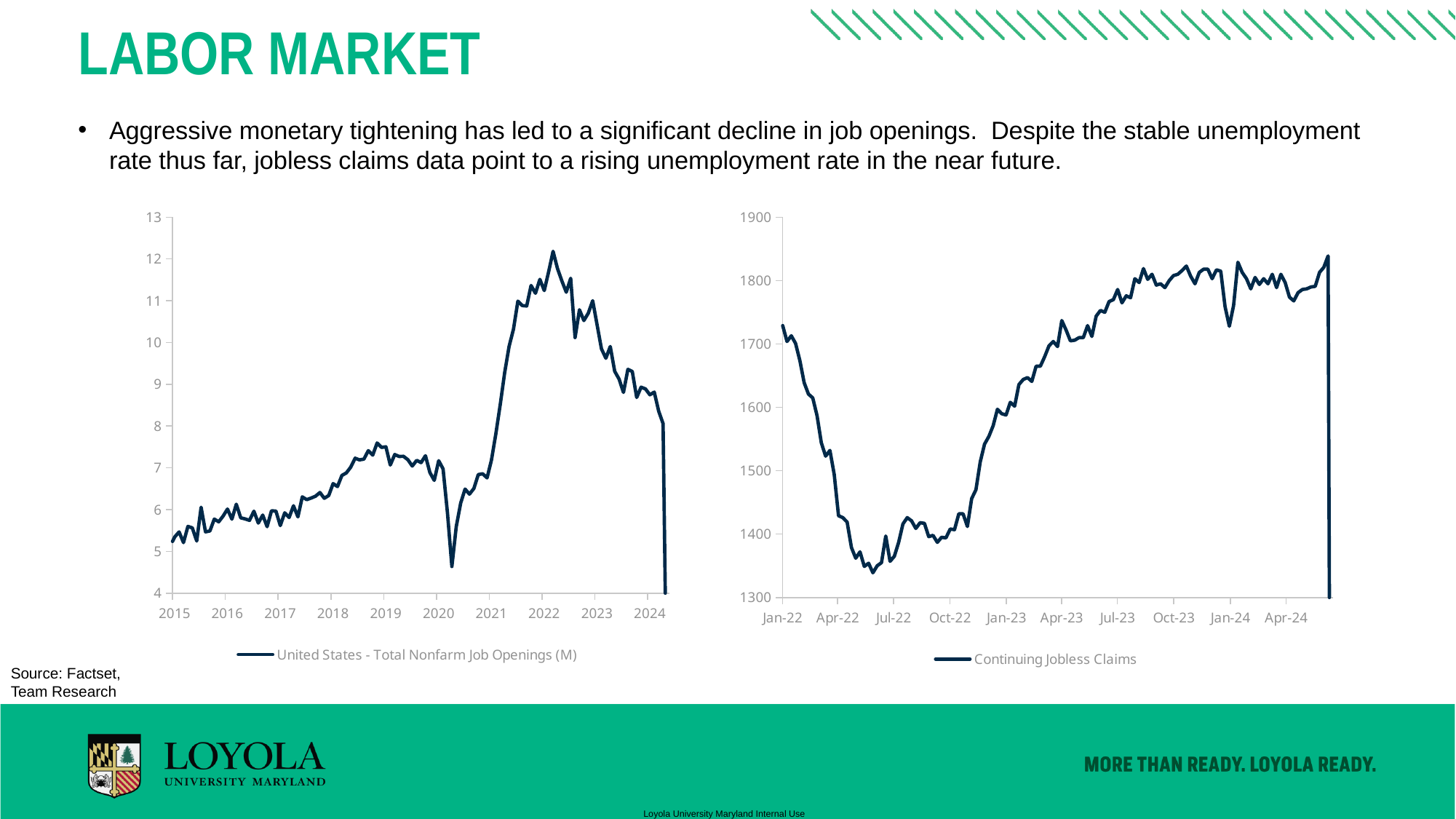
In the right chart, is the lowest value in mid-2022 greater or less than 1400? less In the left chart, is the lowest value in 2020 greater or less than 5? less What kind of chart is the right chart, 'Continuing Jobless Claims'? line chart How many year labels are shown on the x axis of the left chart? 10 What kind of chart is the left chart, 'United States - Total Nonfarm Job Openings (M)'? line chart In the left chart, do job openings rise or fall between 2022 and 2024? fall In the right chart, do continuing jobless claims rise or fall between Jul-22 and Jul-23? rise How many series does the legend of the left chart list? 1 What is the legend entry of the right chart? Continuing Jobless Claims In the left chart, is the peak value reached in 2022 greater or less than 11? greater